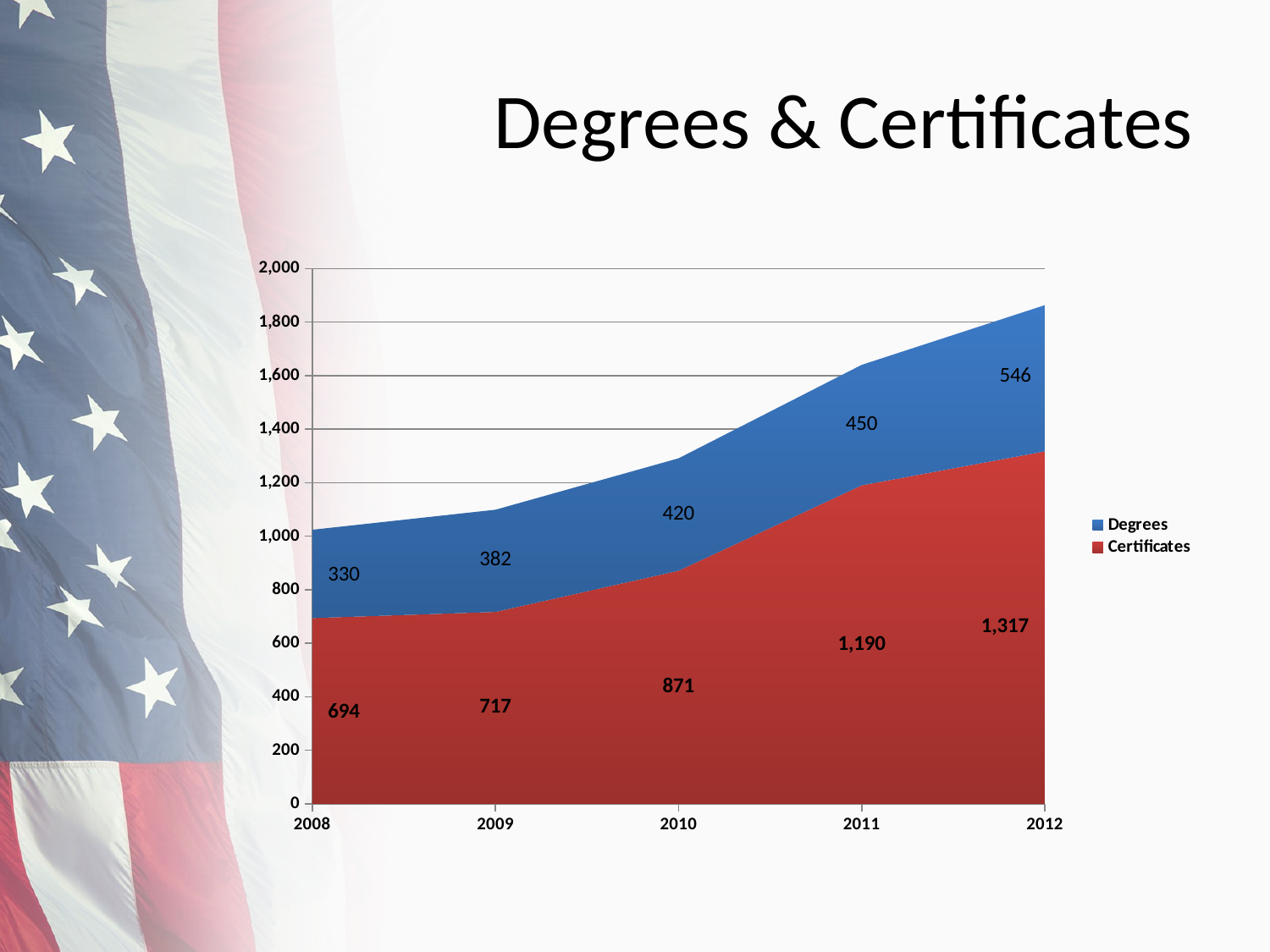
Do the Certificates values rise or fall from 2008 to 2012? Rise Which is larger, the Degrees value in 2009 or the Degrees value in 2010? 2010 What is the value for Degrees in 2011? 450 In which year is the Certificates value lowest? 2008 What is the difference between the Certificates values for 2011 and 2010? 319 In which year is the Degrees value highest? 2012 How many series does the legend list? 2 What is the combined total of Degrees and Certificates in 2012? 1,863 What is the value for Certificates in 2012? 1,317 What kind of chart is shown on the slide? Stacked area chart What is the value for Certificates in 2010? 871 How many years are shown on the x axis? 5